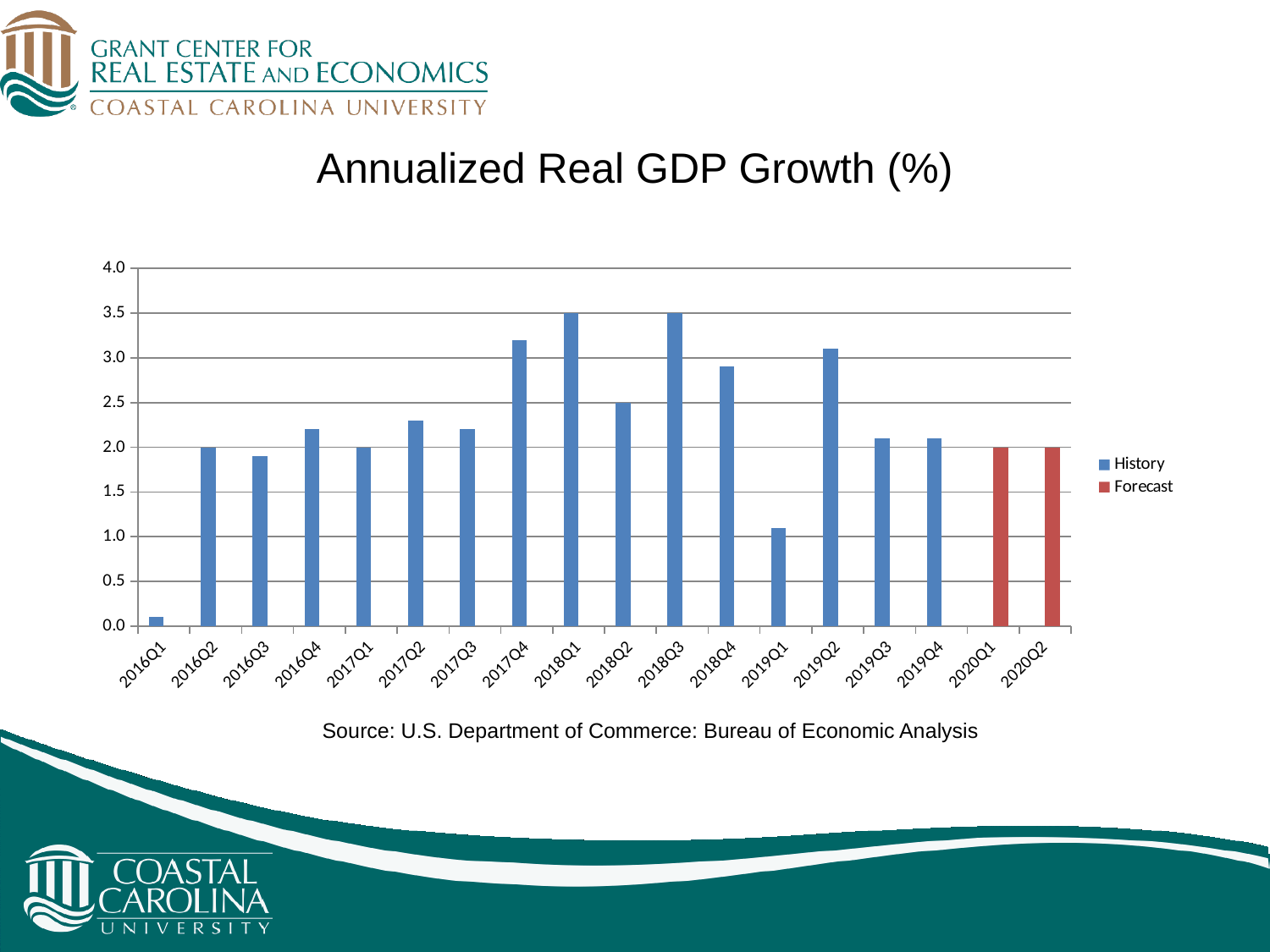
Which quarter has the lowest annualized real GDP growth? 2016Q1 What is the forecast annualized real GDP growth for 2020Q1? 2.0 What is the difference between the values for 2018Q1 and 2018Q2? 1.0 Is the value for 2017Q4 greater or less than 3.0? greater Is the value for 2019Q1 greater or less than 1.5? less Which is larger, the value for 2019Q1 or the value for 2019Q2? 2019Q2 What is the annualized real GDP growth for 2018Q1? 3.5 What kind of chart is shown on the slide? bar chart Which series is shown in red in the legend? Forecast How many quarters are shown on the x axis? 18 What is the annualized real GDP growth for 2018Q2? 2.5 How many series does the legend list? 2